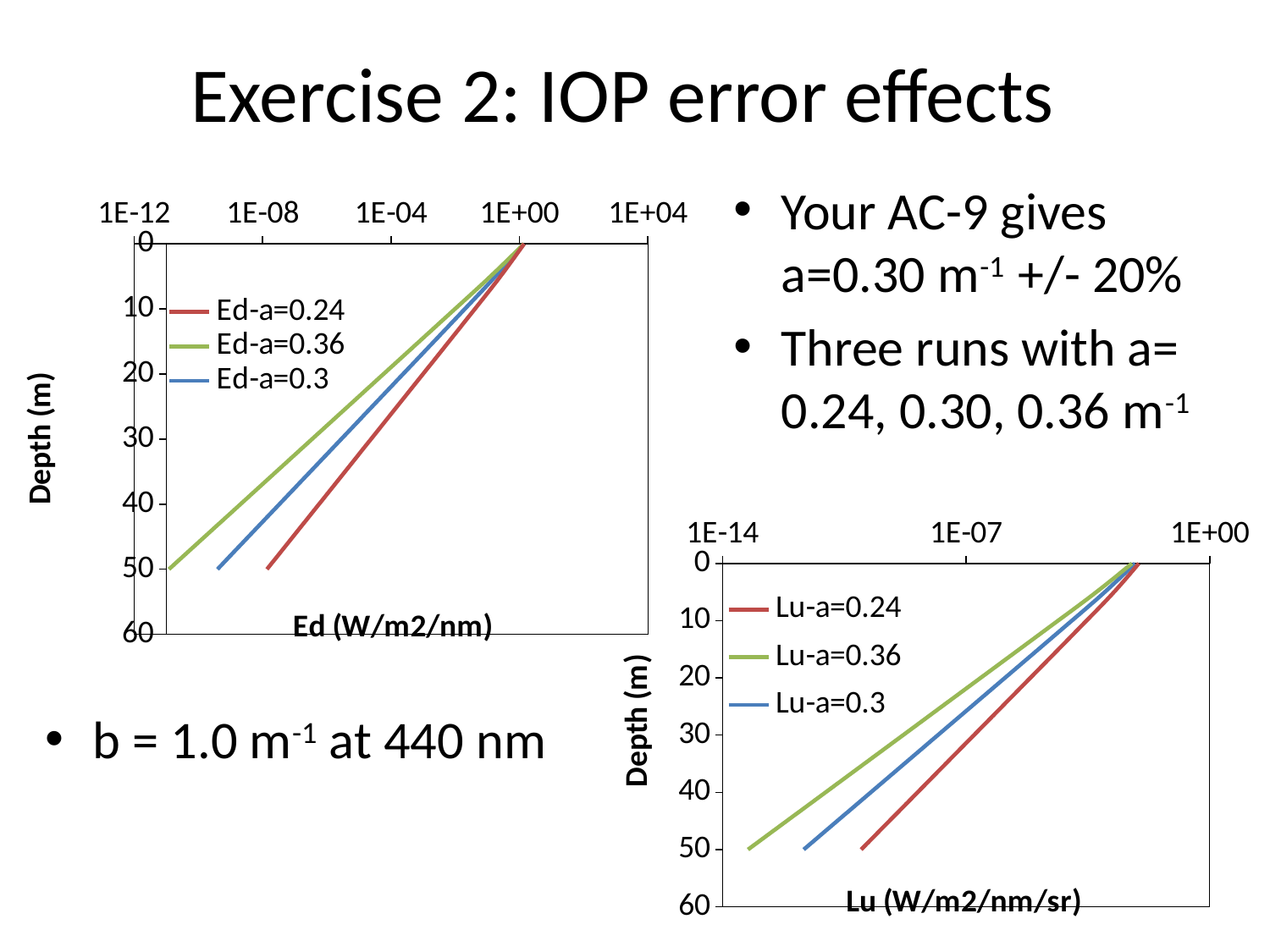
In the Lu (W/m2/nm/sr) chart, is the Lu-a=0.36 value at 50 m depth greater or less than 1E-07? less In the Ed (W/m2/nm) chart, do the Ed values rise or fall as depth increases? fall How many series does the legend of the Lu (W/m2/nm/sr) chart list? 3 In the Ed (W/m2/nm) chart, is the Ed-a=0.24 value at 50 m depth greater or less than 1E-04? less How many series does the legend of the Ed (W/m2/nm) chart list? 3 In the Ed (W/m2/nm) chart, which series has the highest Ed value at 50 m depth? Ed-a=0.24 In the Ed (W/m2/nm) chart, which series has the lowest Ed value at 50 m depth? Ed-a=0.36 In the Lu (W/m2/nm/sr) chart, at 50 m depth, which is larger: Lu-a=0.24 or Lu-a=0.36? Lu-a=0.24 In the Lu (W/m2/nm/sr) chart, do the Lu values rise or fall as depth increases? fall What is the vertical axis title of the Lu (W/m2/nm/sr) chart? Depth (m) What kind of chart is the Ed (W/m2/nm) chart on the left of the slide? line chart In the Ed (W/m2/nm) chart, what are the three legend entries? Ed-a=0.24, Ed-a=0.36, Ed-a=0.3